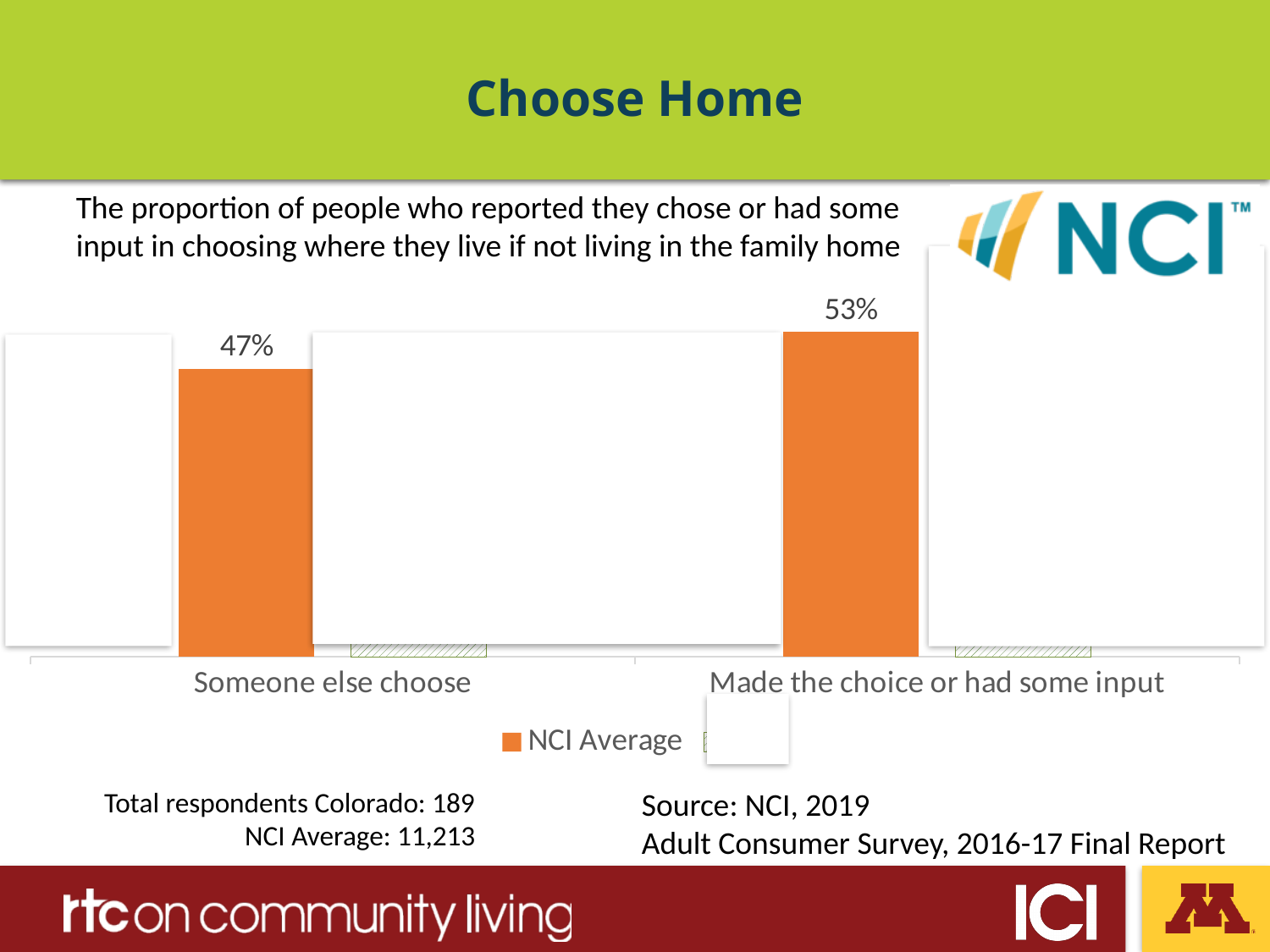
What is the title of the slide containing the chart? Choose Home What colour are the NCI Average bars in the chart? Orange Which category has the lower NCI Average value? Someone else choose How many categories are shown on the x axis of the chart? 2 Is the NCI Average value larger for "Someone else choose" or for "Made the choice or had some input"? Made the choice or had some input What is the NCI Average value for "Someone else choose"? 47% Which category has the higher NCI Average value? Made the choice or had some input What kind of chart is shown on the slide? Bar chart What is the difference between the NCI Average values for "Made the choice or had some input" and "Someone else choose"? 6% What is the NCI Average value for "Made the choice or had some input"? 53%